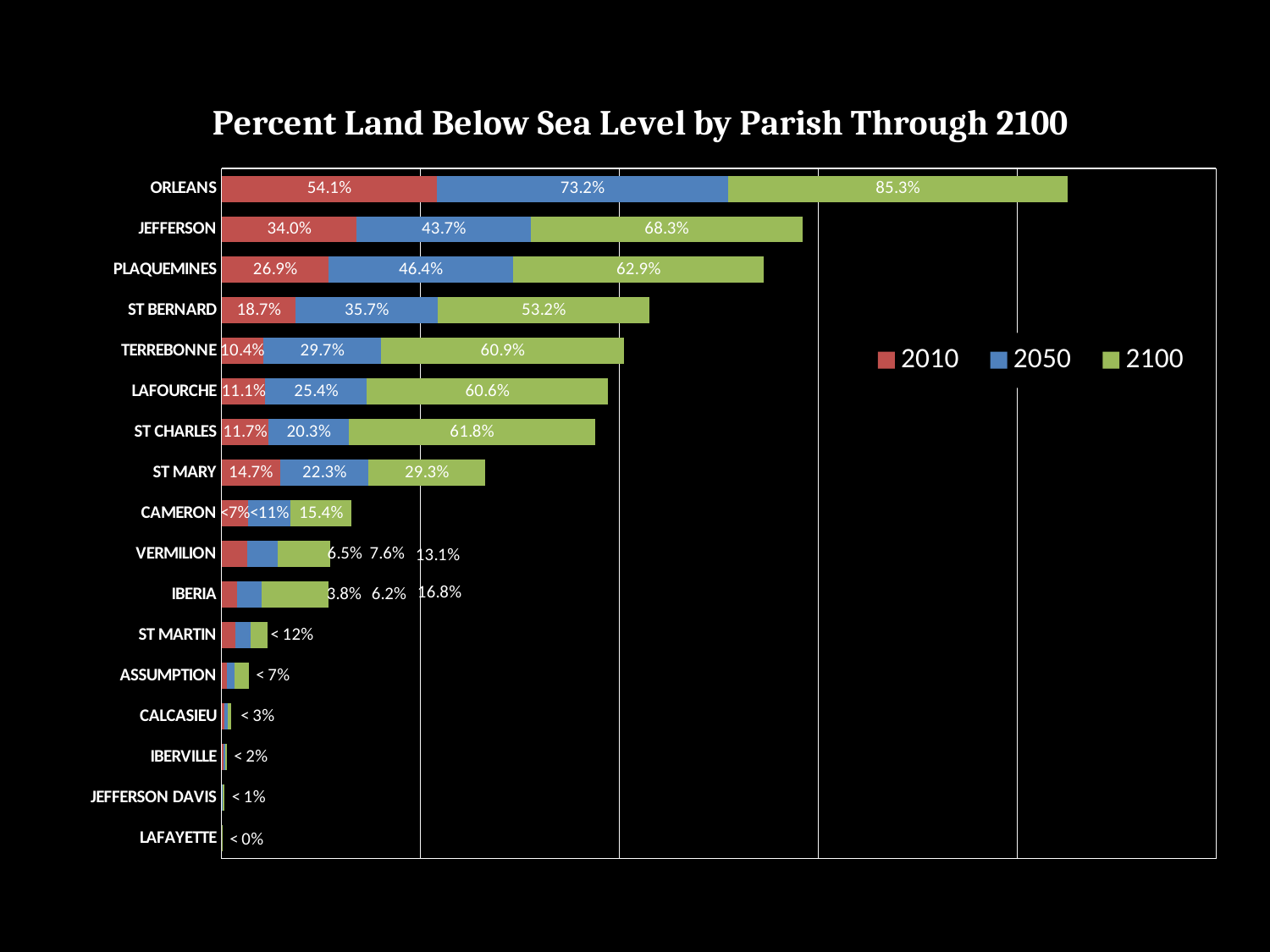
How many series does the legend list? 3 What is the title of the chart? Percent Land Below Sea Level by Parish Through 2100 What type of chart is shown on the slide? Stacked bar chart What is the total of the three stacked segments for Orleans? 212.6% Which is larger, the 2100 value for St Charles or the 2100 value for St Mary? St Charles What is the difference between the 2100 and 2010 values for Orleans? 31.2 percentage points What is the difference between the 2050 and 2010 values for Jefferson? 9.7 percentage points How many parishes are shown on the chart? 17 What is the 2050 value for Plaquemines? 46.4% What is the 2100 value for Orleans? 85.3% What is the 2010 value for St Bernard? 18.7% Which parish has the highest 2100 value? Orleans